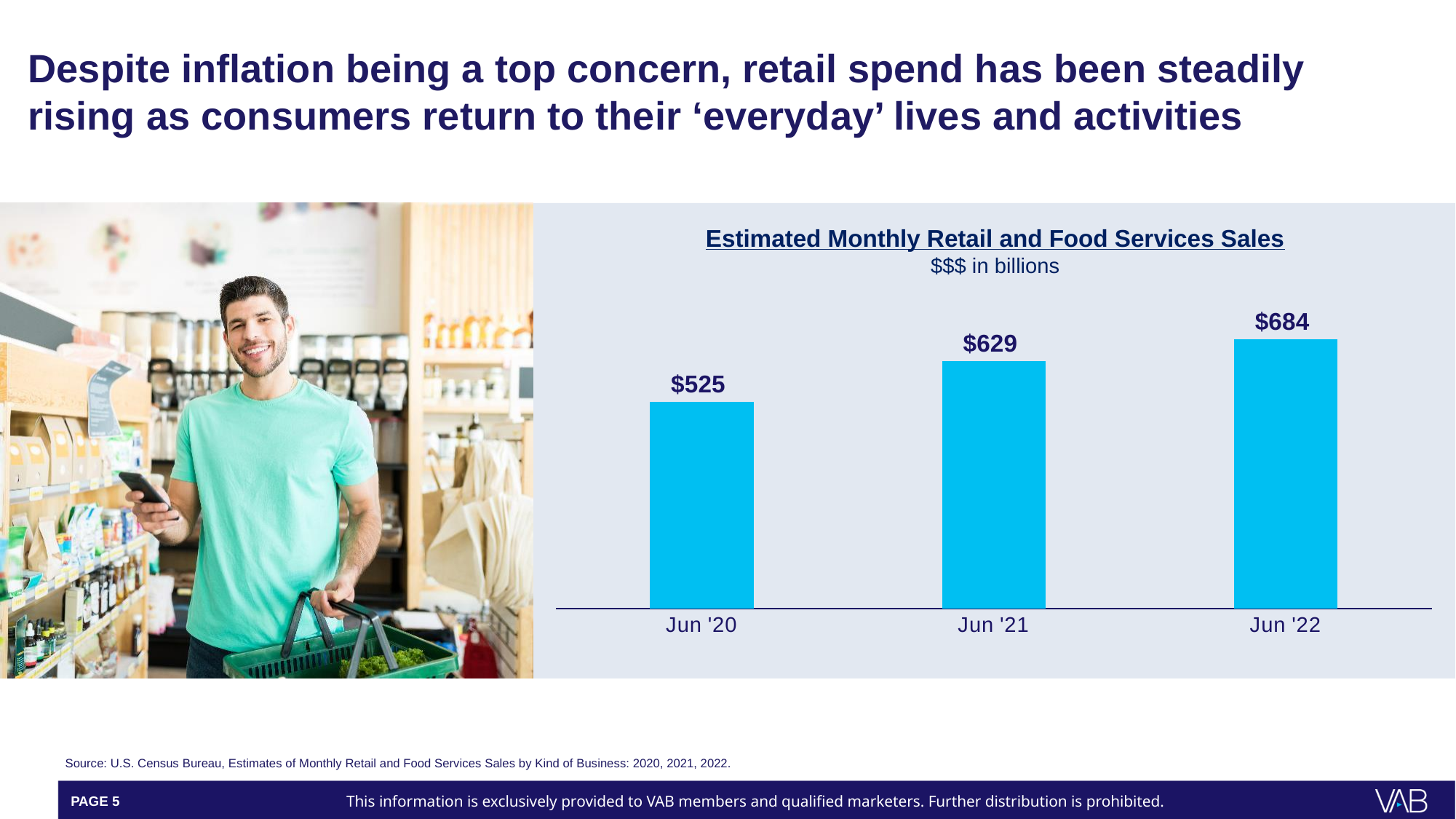
What kind of chart is shown on the slide? Bar chart How many months are shown on the chart? 3 What is the value for Jun '21? $629 Which month has the lowest estimated sales? Jun '20 What is the difference between the values for Jun '21 and Jun '20? $104 Do the values rise or fall from Jun '20 to Jun '22? Rise Which is larger, the value for Jun '21 or the value for Jun '22? Jun '22 What is the difference between the values for Jun '22 and Jun '20? $159 What is the title of the chart? Estimated Monthly Retail and Food Services Sales Which month has the highest estimated sales? Jun '22 What is the value for Jun '20? $525 What is the value for Jun '22? $684